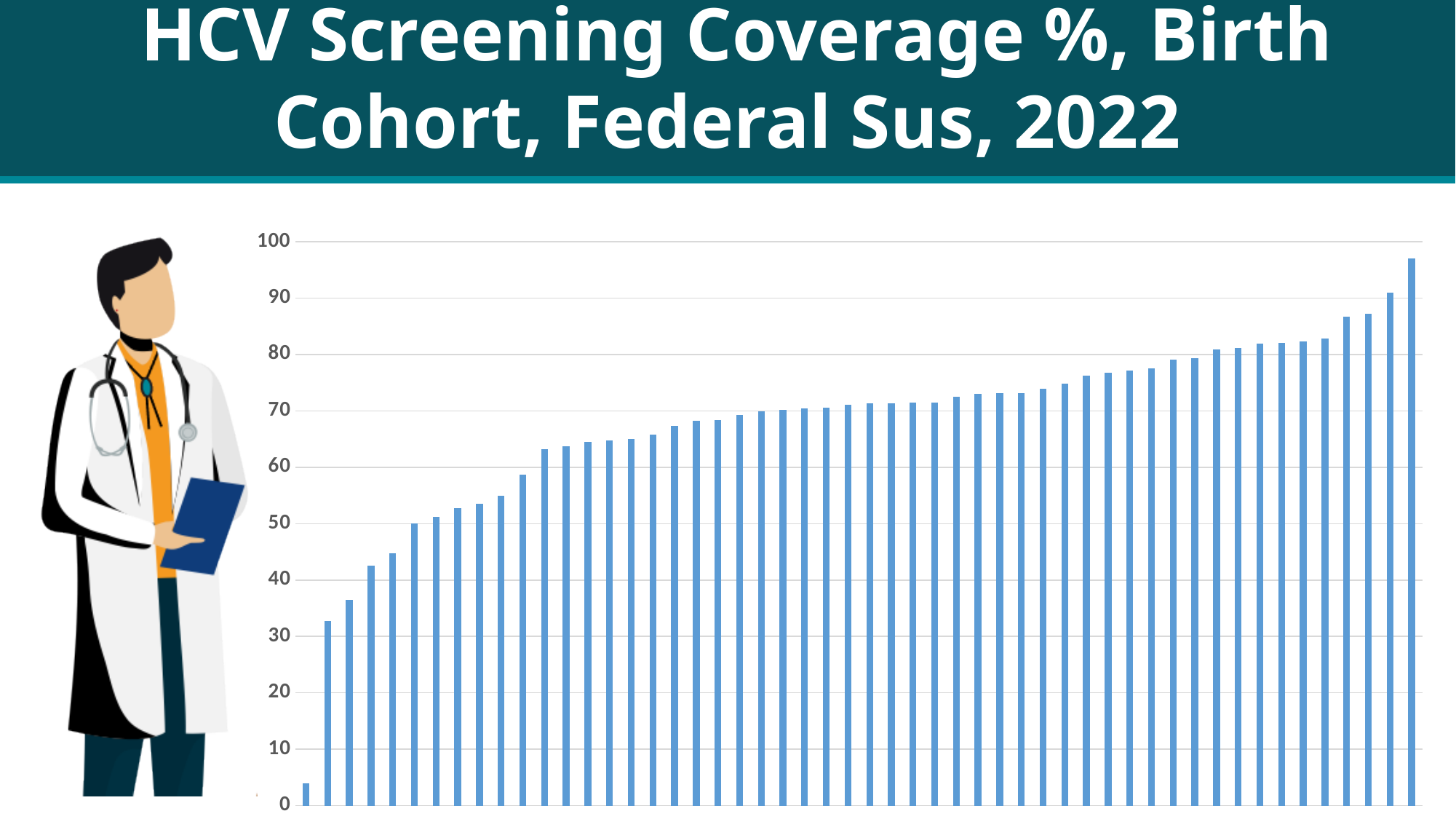
What is the highest value shown on the vertical axis? 100 Is the value of the leftmost bar greater or less than 10? less Is the value of the second bar from the left greater or less than 30? greater Is the value of the rightmost bar greater or less than 90? greater What is the title of the chart? HCV Screening Coverage %, Birth Cohort, Federal Sus, 2022 Which bar is the shortest in the chart? the leftmost bar What kind of chart is shown on the slide? bar chart Which bar is the tallest in the chart? the rightmost bar Do the bar values rise or fall from left to right across the chart? rise Which is larger, the leftmost bar or the rightmost bar? the rightmost bar